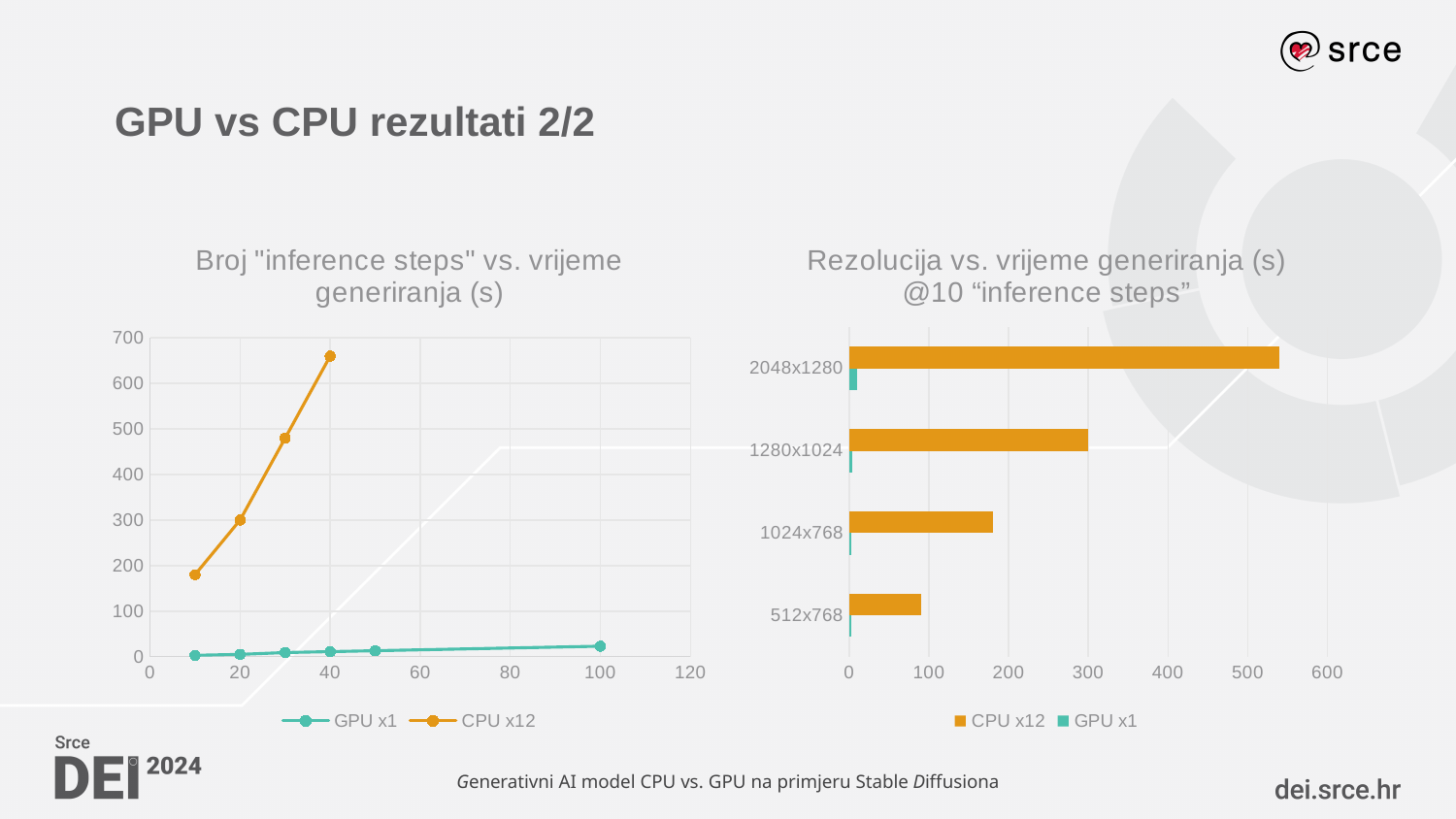
On the right chart, which resolution has the highest CPU x12 value? 2048x1280 How many resolution categories are shown on the right chart? 4 On the left chart, is the CPU x12 value at 40 inference steps greater or less than 600? greater How many series does the legend of the left chart list? 2 What kind of chart is the left chart, titled 'Broj "inference steps" vs. vrijeme generiranja (s)'? line chart On the left chart, does the CPU x12 series rise or fall as the number of inference steps increases? rise On the right chart, which resolution has the lowest CPU x12 value? 512x768 On the right chart, which colour represents the CPU x12 series? orange On the right chart, is the CPU x12 value for 512x768 greater or less than 100? less On the right chart, is the CPU x12 value for 2048x1280 greater or less than 500? greater On the left chart, which series is larger at 30 inference steps, GPU x1 or CPU x12? CPU x12 What kind of chart is the right chart, titled 'Rezolucija vs. vrijeme generiranja (s) @10 "inference steps"'? bar chart